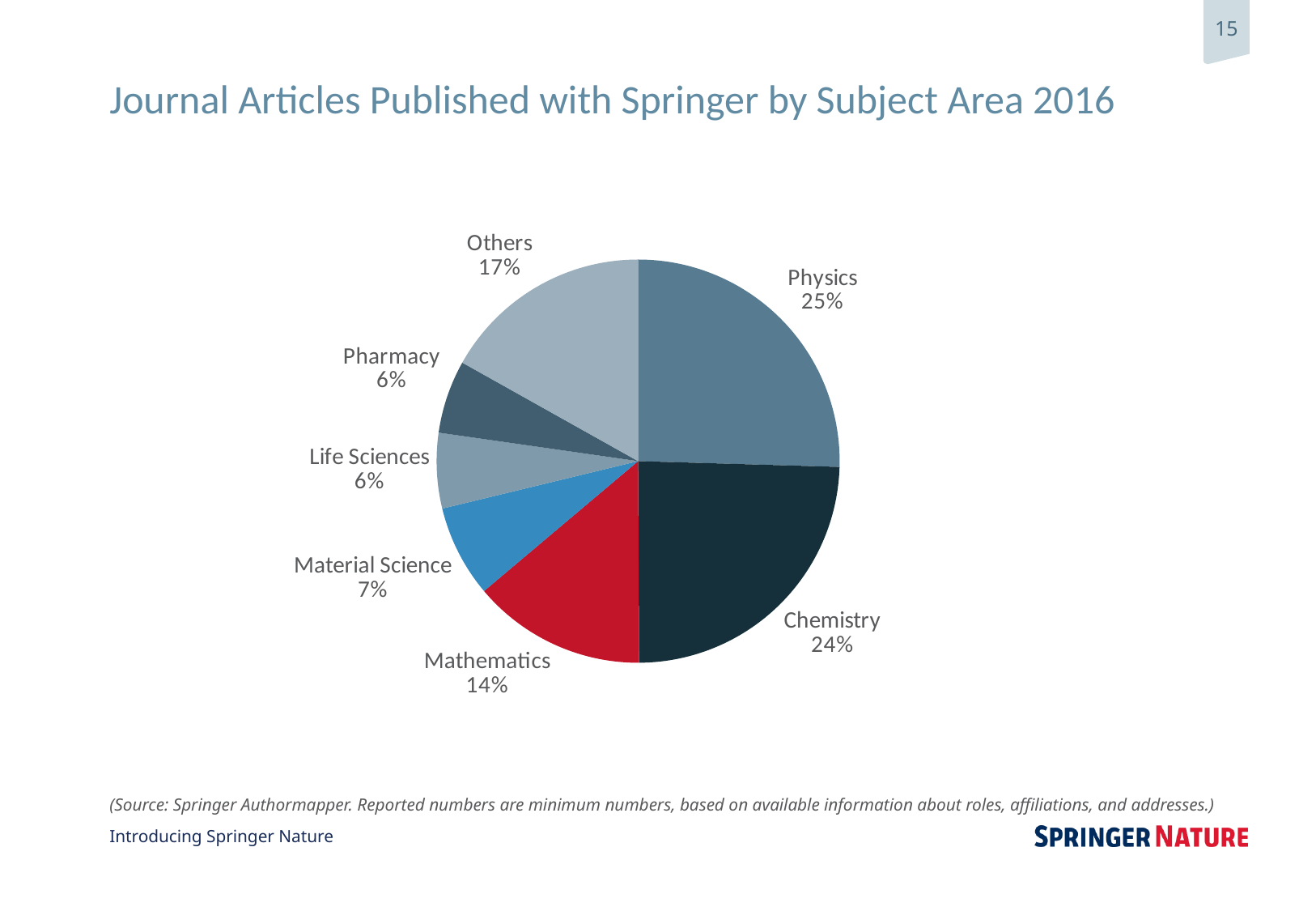
What type of chart is shown on the slide? Pie chart What is the difference in percentage points between Physics and Chemistry? 1% What is the title of the chart? Journal Articles Published with Springer by Subject Area 2016 Which subject area has the smallest share, Material Science or Pharmacy? Pharmacy What percentage is shown for Material Science? 7% What share does the Others slice represent? 17% How many subject area slices does the pie chart have? 7 What share of journal articles published with Springer in 2016 were in Physics? 25% What is the difference between the Others share and the Mathematics share? 3% Which subject area has the largest share of the pie? Physics Which is larger, the Chemistry slice or the Mathematics slice? Chemistry What percentage of the pie is Mathematics? 14%